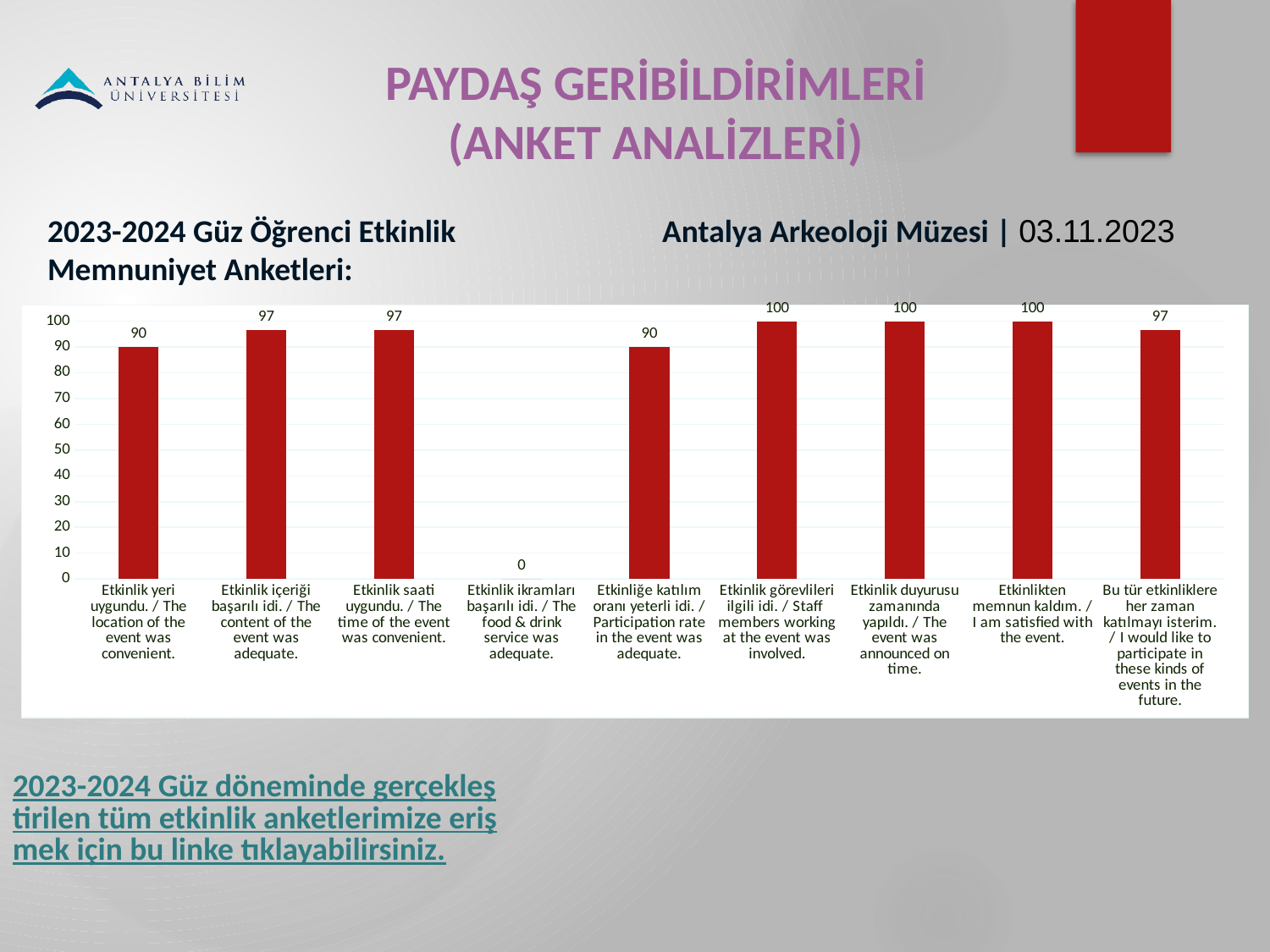
What value is shown for "The location of the event was convenient"? 90 Which category has the lowest value in the chart? Etkinlik ikramları başarılı idi. / The food & drink service was adequate. What kind of chart is shown on the slide? Bar chart What value is shown for "The food & drink service was adequate"? 0 What value is shown for "I am satisfied with the event"? 100 What value is shown for "I would like to participate in these kinds of events in the future"? 97 How many categories in the chart have a value of 100? 3 Which is larger: the value for "The time of the event was convenient" or the value for "Participation rate in the event was adequate"? The time of the event was convenient What is the difference between the value for "The content of the event was adequate" and the value for "The location of the event was convenient"? 7 What is the difference between the value for "The event was announced on time" and the value for "Participation rate in the event was adequate"? 10 What colour are the bars in the chart? Dark red How many categories are shown in the bar chart? 9